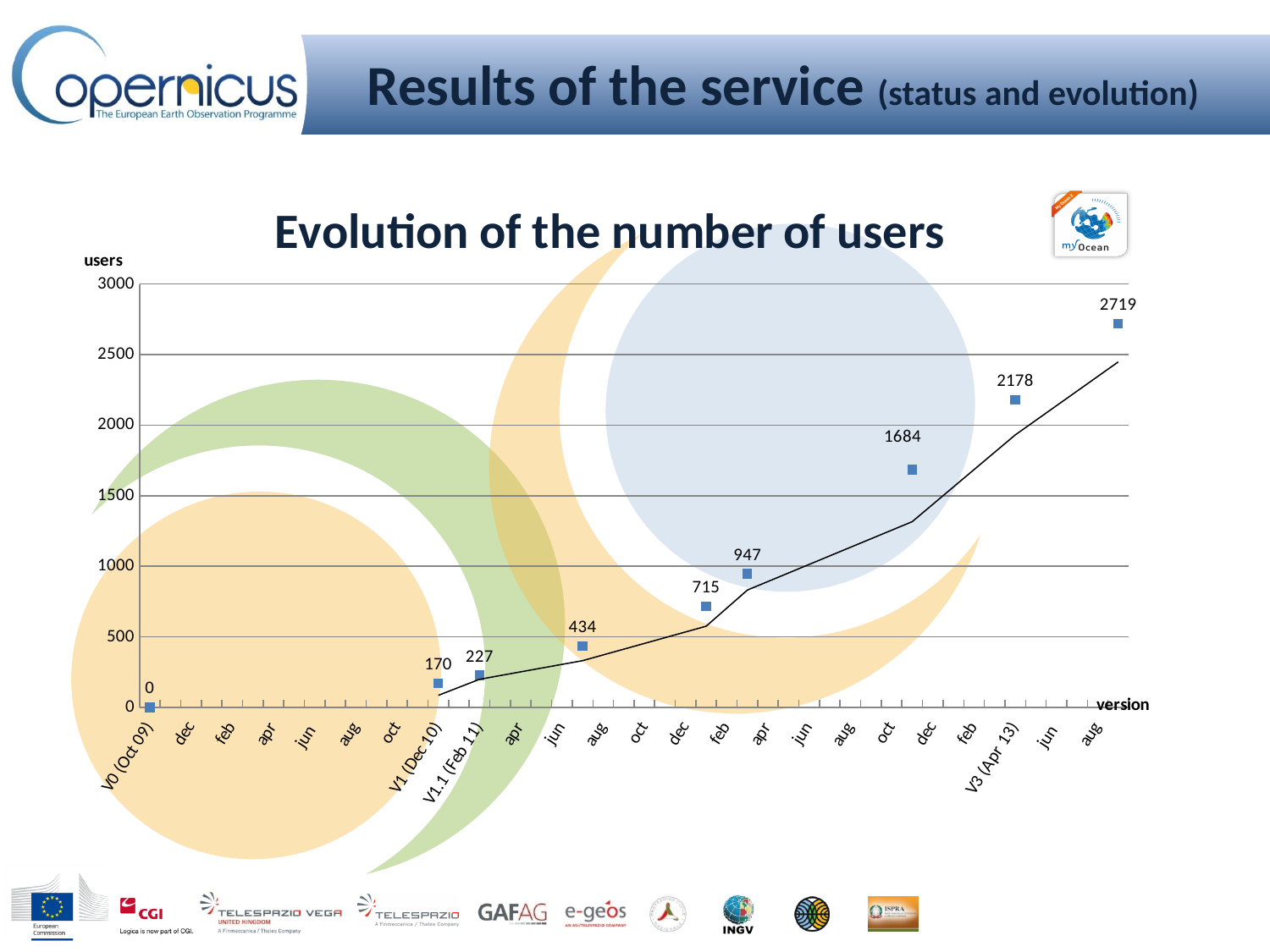
What is the number of users at V1.1 (Feb 11)? 227 What is the lowest number of users labeled on the chart? 0 What is the highest number of users labeled on the chart? 2719 What is the title of the chart? Evolution of the number of users How many labeled data points are plotted on the chart? 9 Is the data point labeled 1684 greater or less than 1500 on the users axis? greater What is the number of users at V1 (Dec 10)? 170 What is the number of users at V0 (Oct 09)? 0 What is the difference between the two highest labeled values, 2719 and 2178? 541 What is the difference between the labeled values 947 and 715? 232 What is the label on the vertical axis of the chart? users Does the number of users rise or fall over time along the x axis? rise